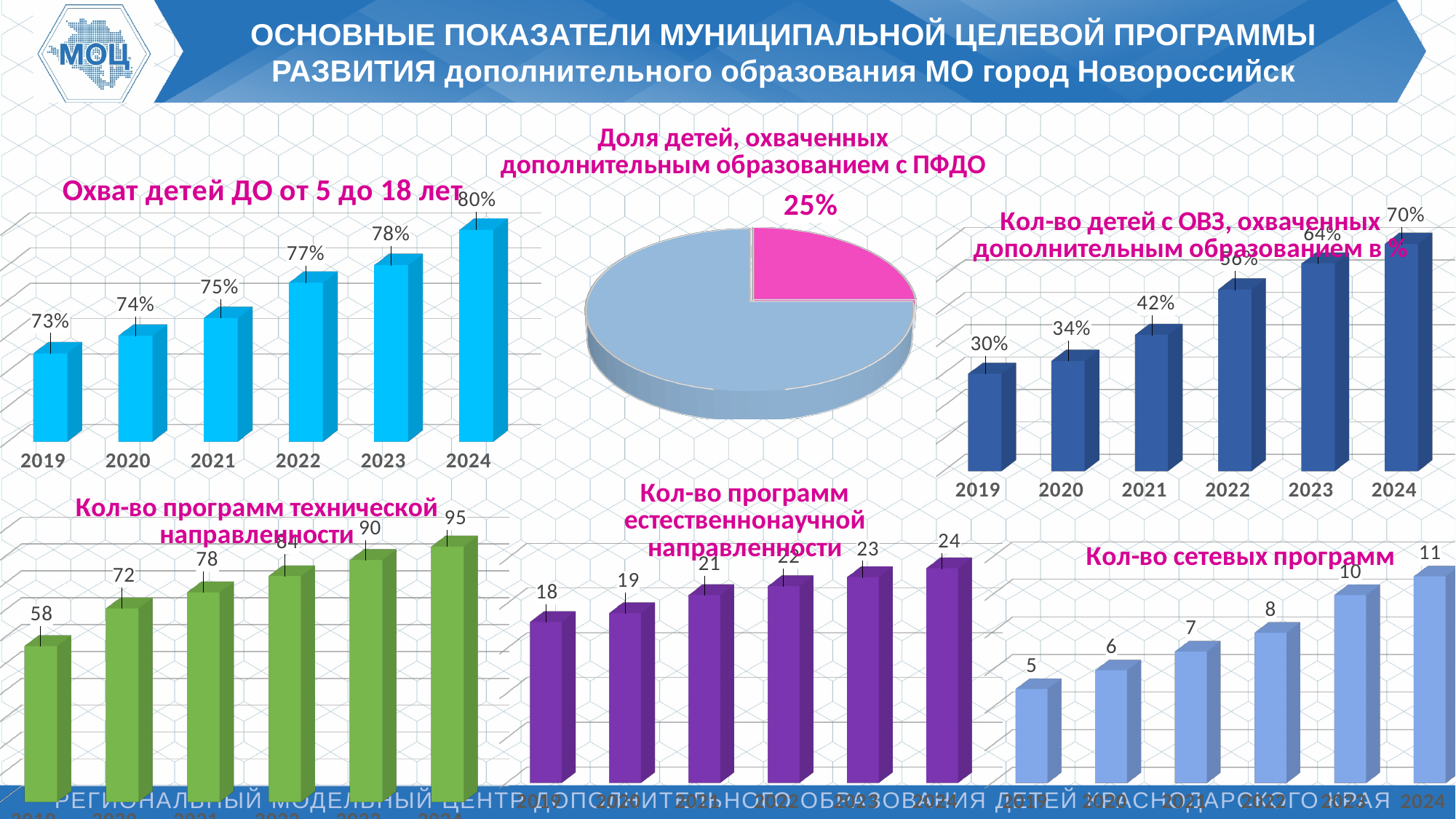
What kind of chart is 'Доля детей, охваченных дополнительным образованием с ПФДО'? pie chart What share of the pie chart 'Доля детей, охваченных дополнительным образованием с ПФДО' does the pink slice represent? 25% In the chart 'Охват детей ДО от 5 до 18 лет', what is the value for 2022? 77% In the chart 'Кол-во программ технической направленности', what is the value of the first (leftmost) bar? 58 In the chart 'Кол-во детей с ОВЗ, охваченных дополнительным образованием в %', do the values rise or fall from 2019 to 2024? rise In the chart 'Кол-во детей с ОВЗ, охваченных дополнительным образованием в %', what is the value for 2021? 42% In the chart 'Охват детей ДО от 5 до 18 лет', what is the difference between the 2024 and 2019 values? 7% In the chart 'Кол-во сетевых программ', what is the difference between the last bar (11) and the first bar (5)? 6 In the chart 'Охват детей ДО от 5 до 18 лет', which year has the highest value? 2024 In the chart 'Охват детей ДО от 5 до 18 лет', how many years are shown on the x axis? 6 In the chart 'Кол-во детей с ОВЗ, охваченных дополнительным образованием в %', which year has the lowest value? 2019 In the chart 'Кол-во программ естественнонаучной направленности', what is the highest value shown? 24